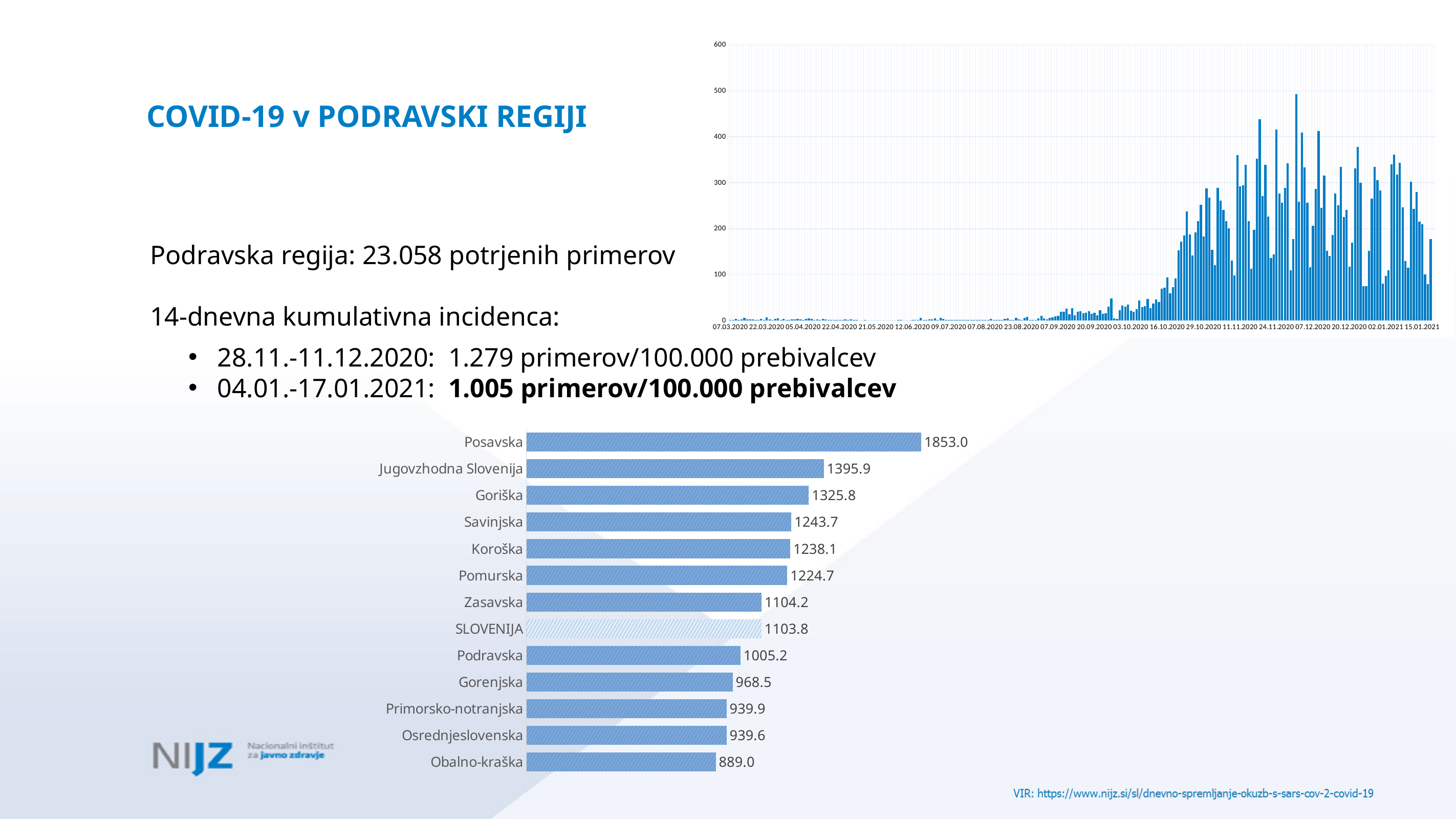
In the top-right chart, is the highest bar greater or less than 400? greater In the bottom horizontal bar chart, what is the value for SLOVENIJA? 1103.8 In the bottom horizontal bar chart, what is the value for Posavska? 1853.0 In the bottom horizontal bar chart, which is larger: the value for Goriška or the value for Savinjska? Goriška What kind of chart is the chart at the bottom of the slide? Bar chart In the top-right chart, what is the highest value shown on the y axis? 600 In the bottom horizontal bar chart, which category has the lowest value? Obalno-kraška In the bottom horizontal bar chart, what is the difference between the values for Posavska and Jugovzhodna Slovenija? 457.1 In the bottom horizontal bar chart, how many categories are shown? 13 In the bottom horizontal bar chart, which category has the highest value? Posavska In the top-right chart, what is the first date label on the x axis? 07.03.2020 In the bottom horizontal bar chart, what is the value for Podravska? 1005.2